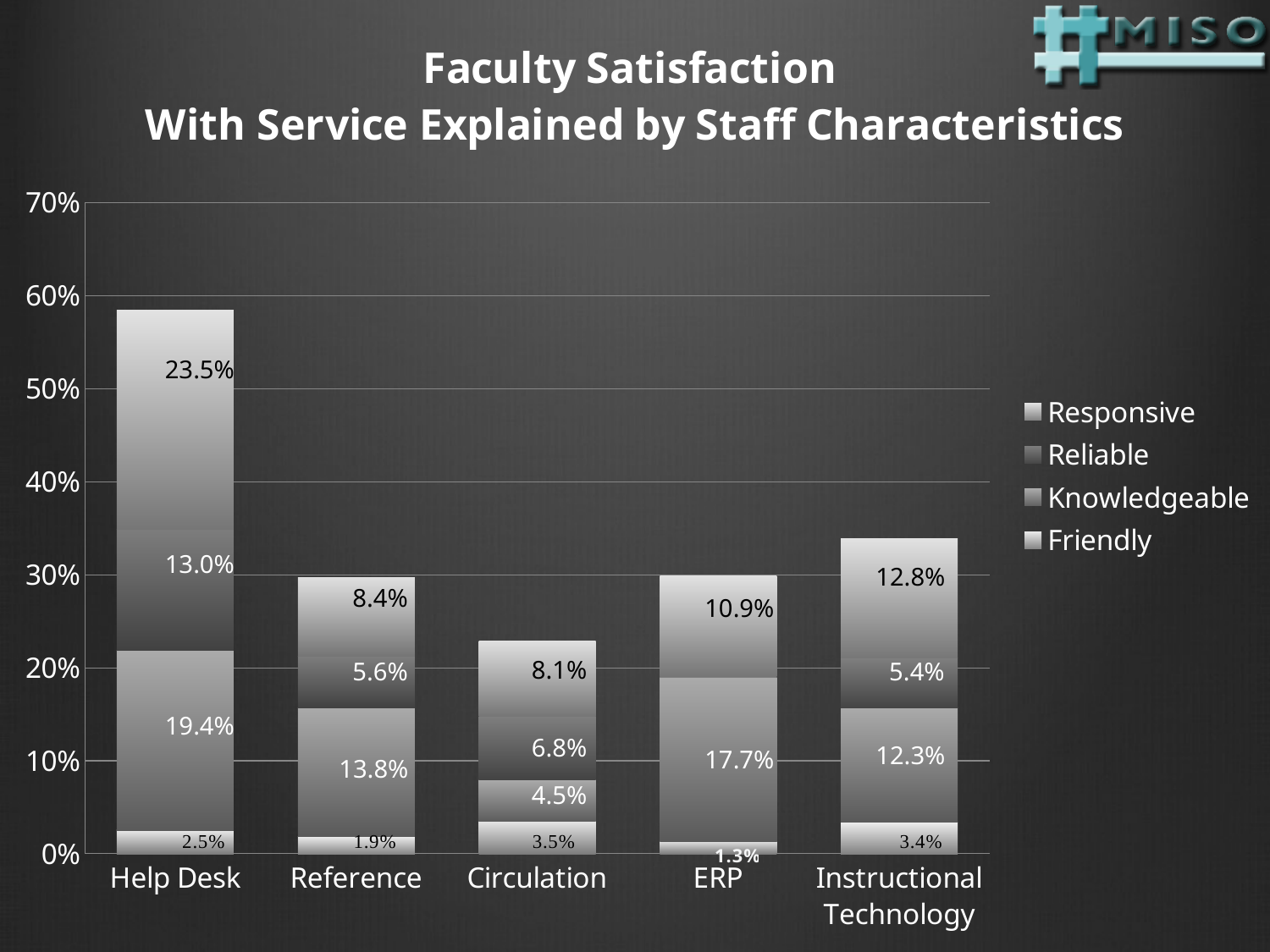
What is the difference between the Responsive value for Help Desk and the Responsive value for Instructional Technology? 10.7 percentage points How many series does the legend list? 4 What is the Knowledgeable value for Reference? 13.8% What is the Responsive value for Help Desk? 23.5% How many service categories are shown on the x axis? 5 Which service category has the shortest stacked bar overall? Circulation What is the total of the stacked bar for Help Desk? 58.4% What is the Friendly value for Circulation? 3.5% Which has the larger Knowledgeable value, ERP or Instructional Technology? ERP Which service category has the tallest stacked bar overall? Help Desk Is the total stacked value for Help Desk greater or less than 50%? greater What kind of chart is shown on the slide? Stacked bar chart